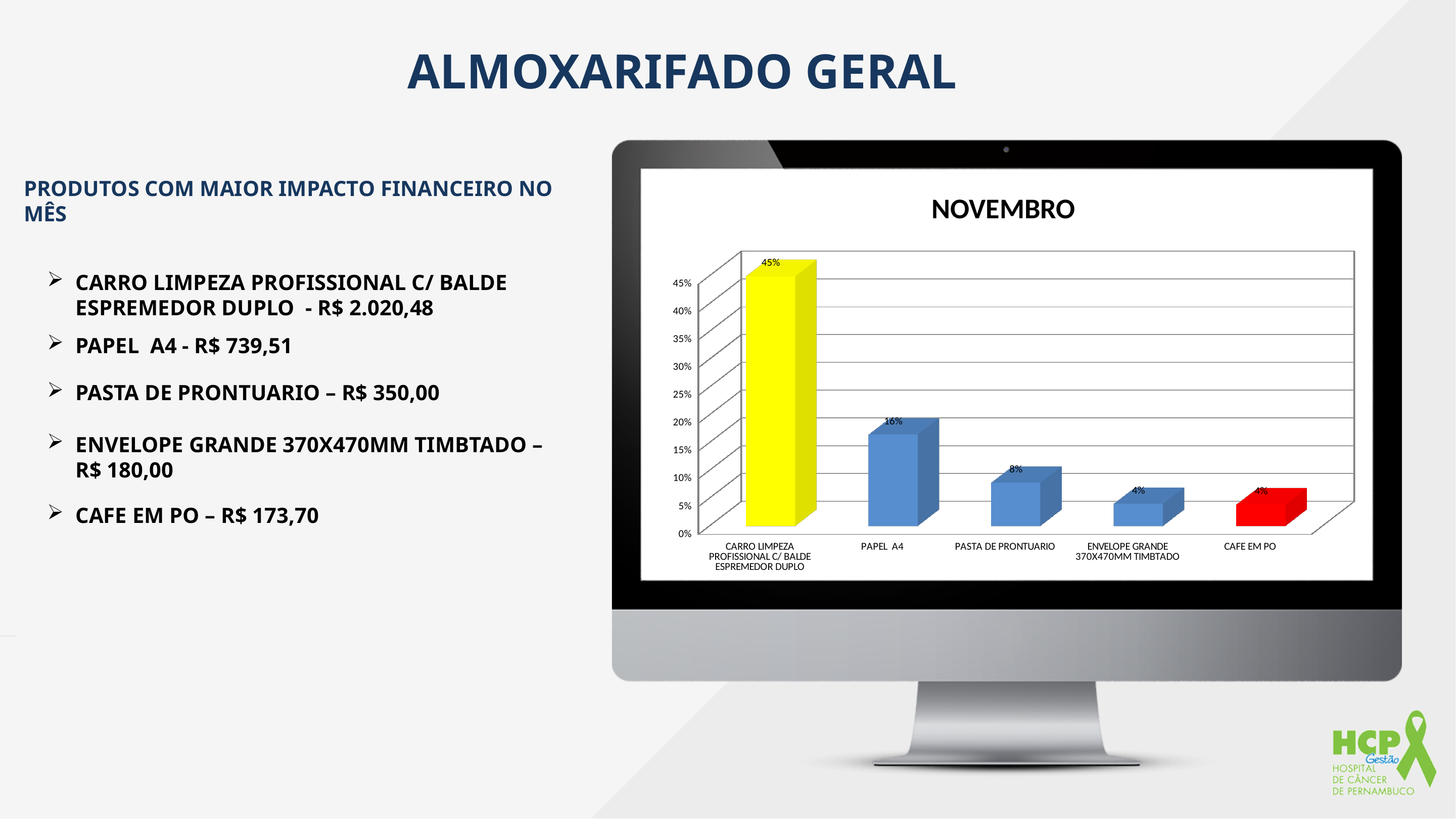
What kind of chart is shown on the slide? Bar chart Which is larger, the value for PAPEL A4 or the value for PASTA DE PRONTUARIO? PAPEL A4 What is the value for PASTA DE PRONTUARIO in the chart? 8% What is the value for CAFE EM PO in the chart? 4% What colour is the bar for CAFE EM PO? Red What is the difference between the values for CARRO LIMPEZA PROFISSIONAL C/ BALDE ESPREMEDOR DUPLO and PAPEL A4? 29% Which category has the highest value in the chart? CARRO LIMPEZA PROFISSIONAL C/ BALDE ESPREMEDOR DUPLO What is the value for PAPEL A4 in the chart? 16% What is the value for CARRO LIMPEZA PROFISSIONAL C/ BALDE ESPREMEDOR DUPLO in the chart? 45% What is the title of the chart? NOVEMBRO Do the values rise or fall from left to right across the categories in the chart? Fall How many categories are plotted in the chart? 5